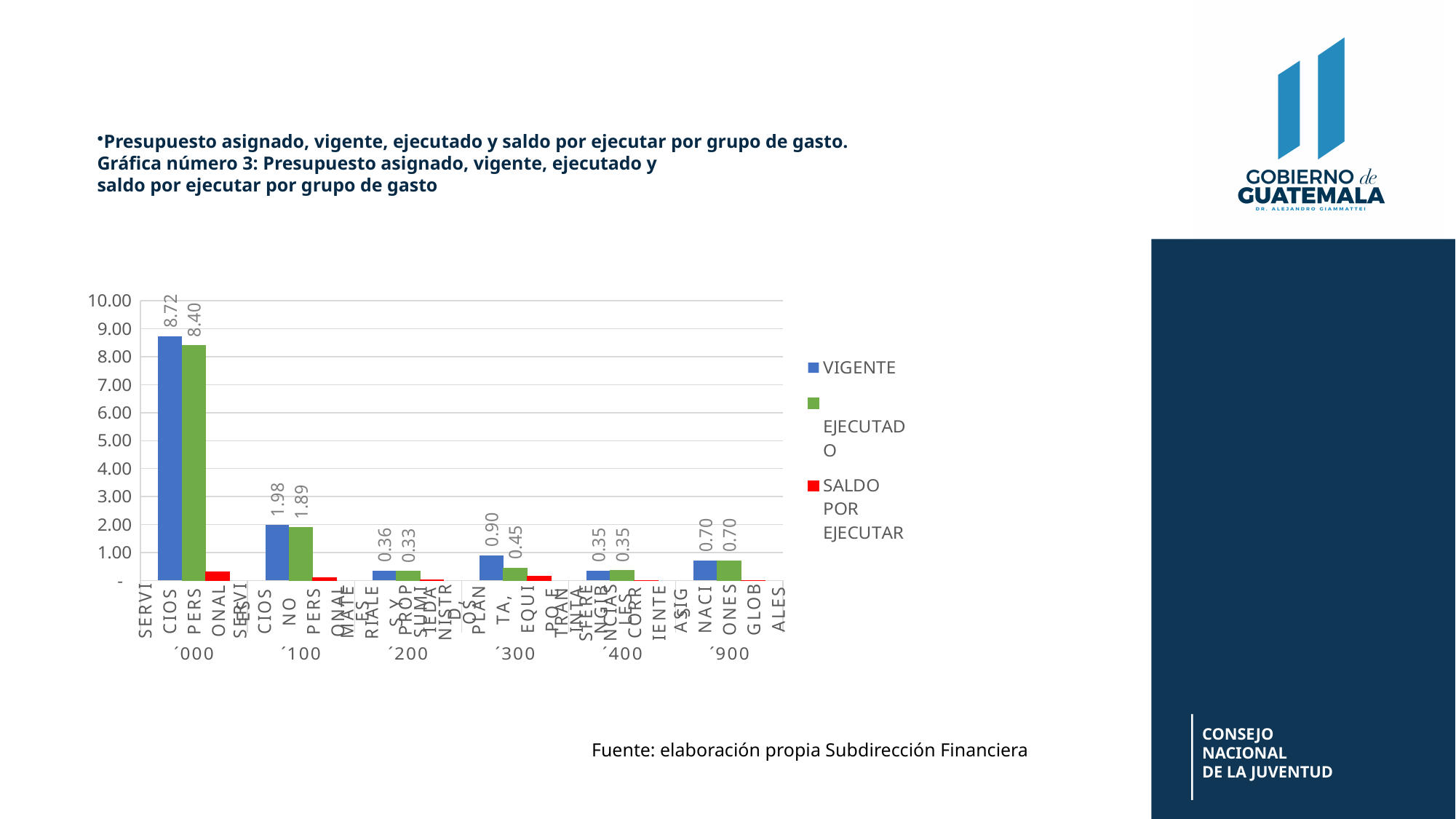
What is the EJECUTADO value for group ´100? 1.89 What is the EJECUTADO value for group ´300? 0.45 How many series does the legend list? 3 How many expense groups are shown on the x axis? 6 What is the difference between the VIGENTE and EJECUTADO values for group ´300? 0.45 Is the SALDO POR EJECUTAR value for group ´000 greater or less than 1.00? less What kind of chart is shown on the slide? bar chart Which group has the highest VIGENTE value? ´000 What is the VIGENTE value for group ´000? 8.72 Which group has the lowest EJECUTADO value? ´200 Which group has a larger VIGENTE value, ´100 or ´900? ´100 What is the difference between the VIGENTE and EJECUTADO values for group ´000? 0.32